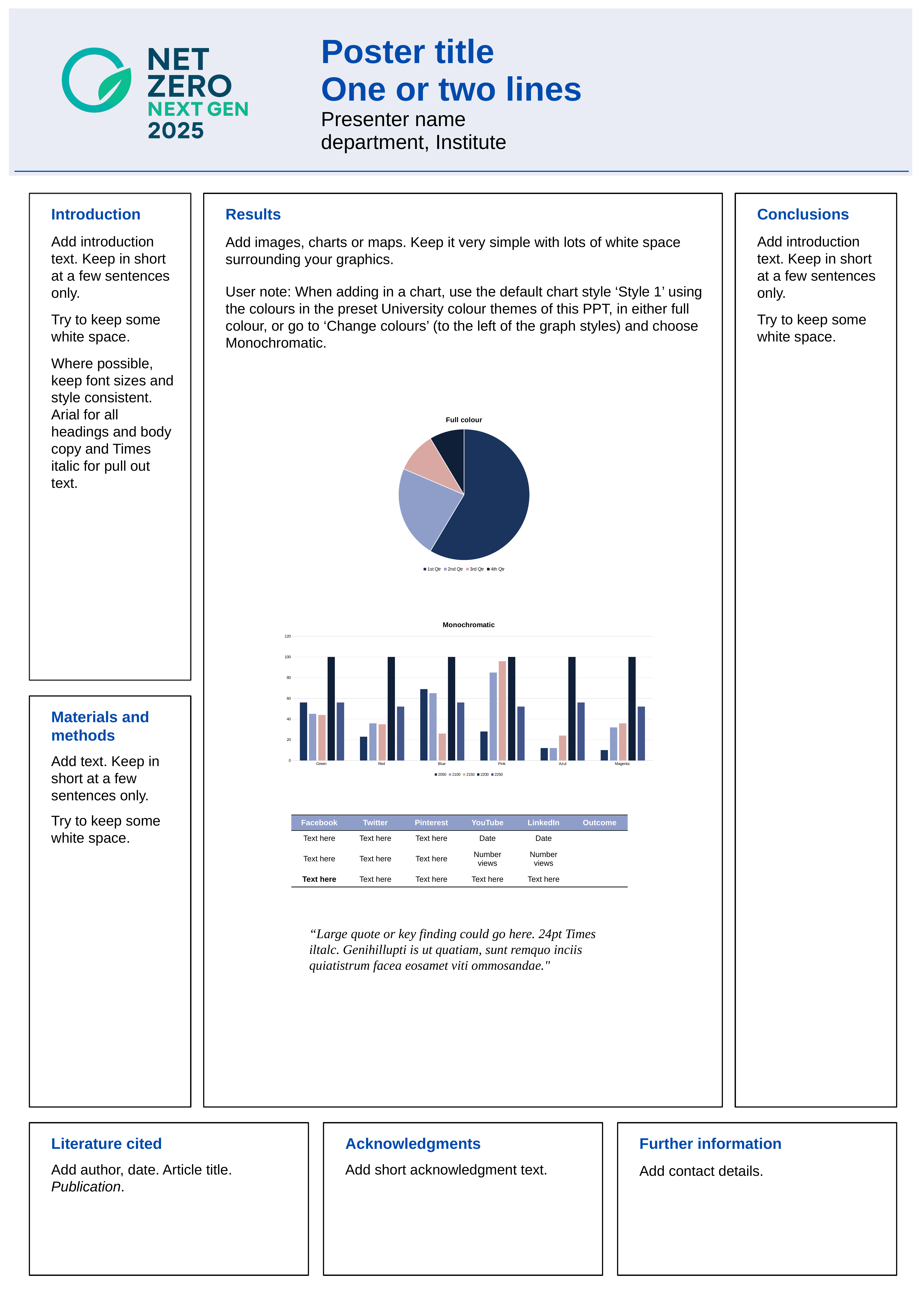
What kind of chart is the chart titled "Monochromatic"? bar chart What kind of chart is the chart titled "Full colour"? pie chart In the "Monochromatic" chart, which category has the highest value for the 2150 series? Pink In the "Monochromatic" chart, which category has a larger 2050 value, Blue or Green? Blue In the "Monochromatic" chart, is the value of the 2050 series for Red greater or less than 40? less How many slices does the "Full colour" pie chart have? 4 In the "Full colour" pie chart, which quarter has the smallest slice? 4th Qtr How many categories are shown on the x axis of the "Monochromatic" chart? 6 In the "Monochromatic" chart, what is the value of the 2200 series for Green? 100 In the "Full colour" pie chart, which quarter has the largest slice? 1st Qtr In the "Full colour" pie chart, which slice is larger, 2nd Qtr or 3rd Qtr? 2nd Qtr How many series does the legend of the "Monochromatic" chart list? 5